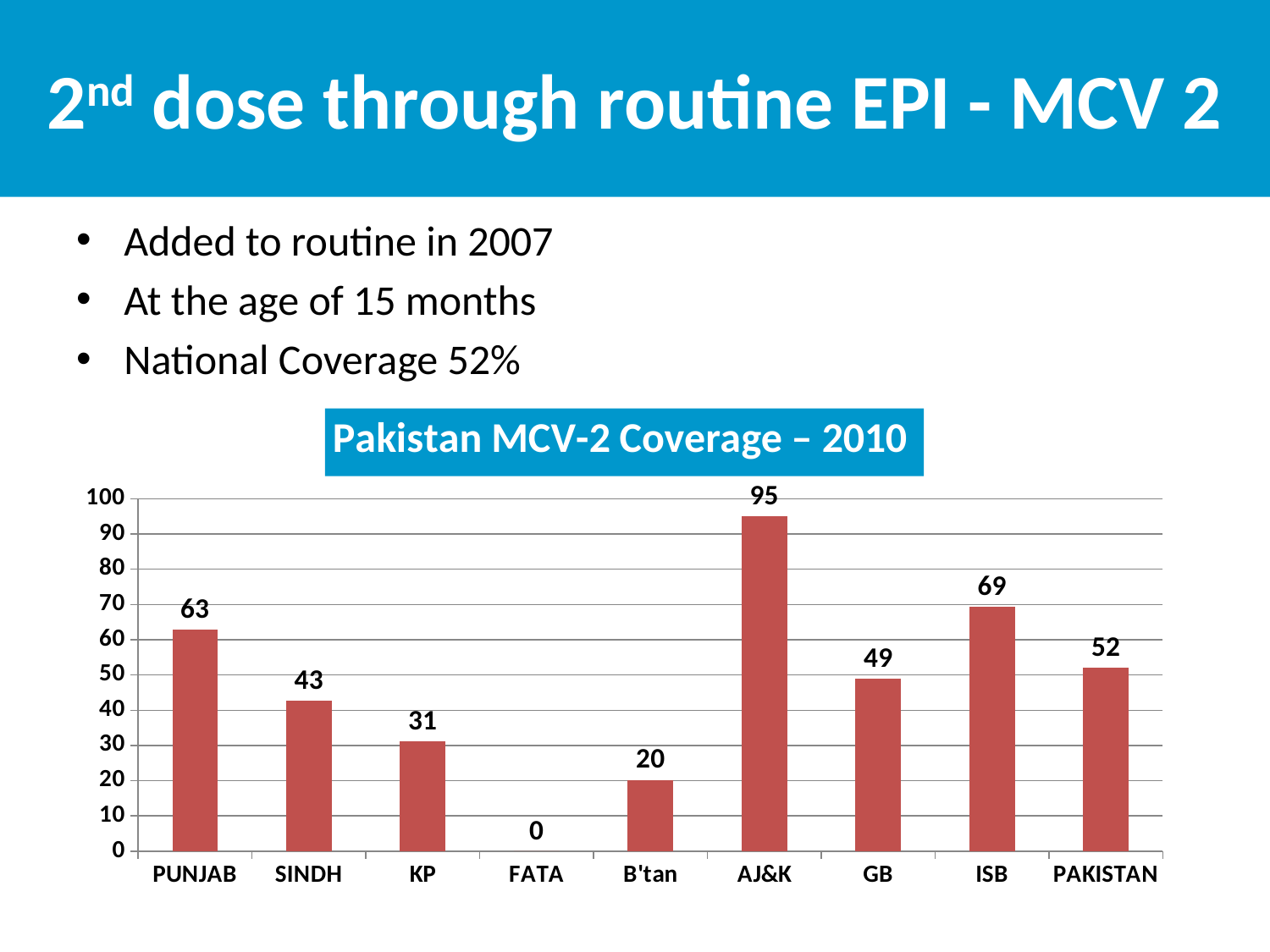
What is the MCV-2 coverage value for PUNJAB? 63 What is the MCV-2 coverage value for FATA? 0 What is the difference between the coverage values for ISB and GB? 20 How many categories are shown on the x axis of the chart? 9 What kind of chart is shown on the slide? bar chart What is the MCV-2 coverage value for AJ&K? 95 What is the title of the chart? Pakistan MCV-2 Coverage – 2010 Is the value for B'tan greater or less than 30? less Which category has the lowest MCV-2 coverage? FATA Which has a higher coverage value, SINDH or KP? SINDH What is the difference between the coverage values for PUNJAB and PAKISTAN? 11 Which category has the highest MCV-2 coverage? AJ&K